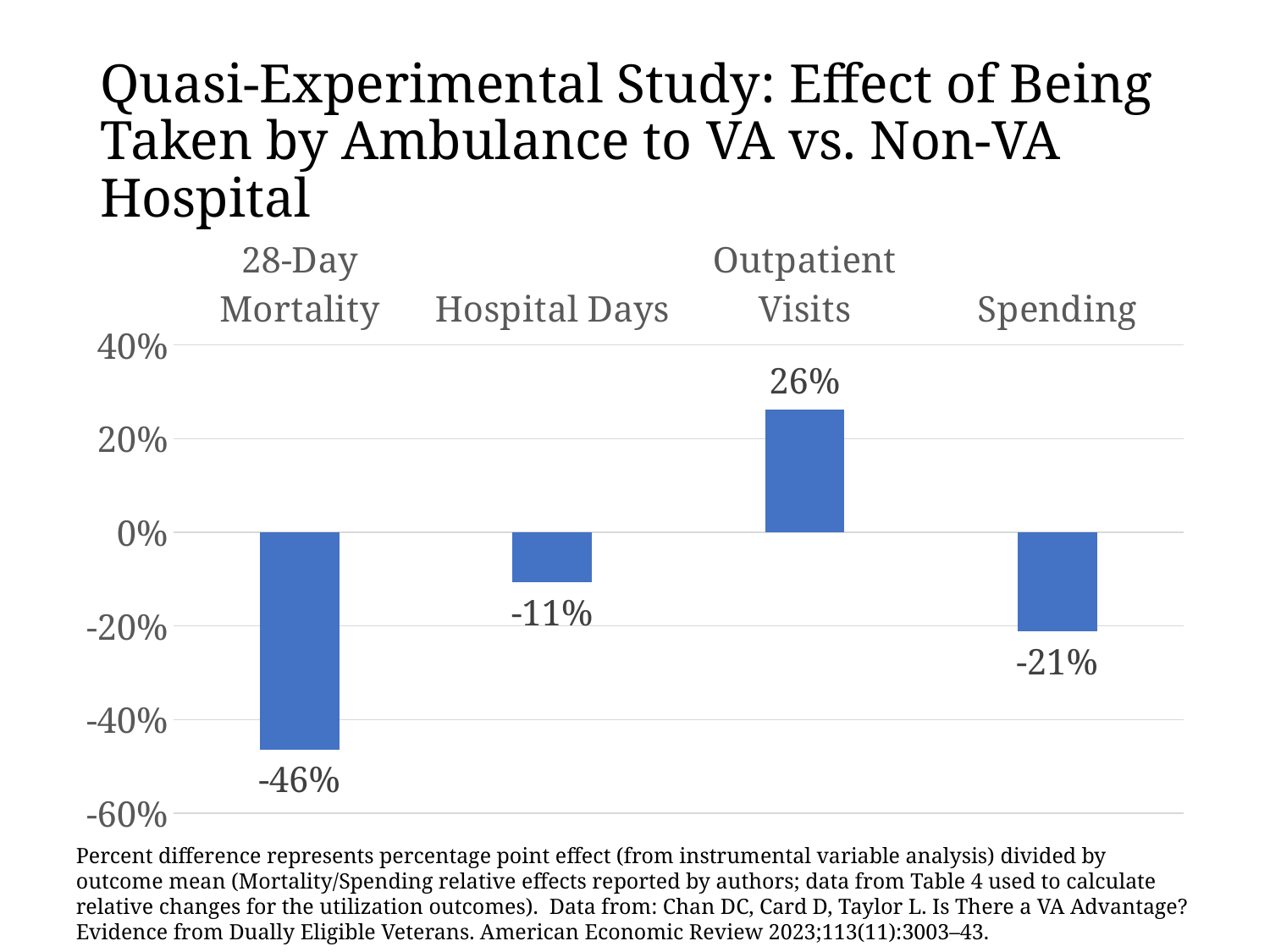
What is the value for Outpatient Visits? 26% Which category has the lowest value? 28-Day Mortality What is the difference between the values for Hospital Days and 28-Day Mortality? 35 percentage points What is the value for 28-Day Mortality? -46% How many categories have a negative value? 3 How many categories are shown in the chart? 4 What is the value for Hospital Days? -11% What kind of chart is shown on the slide? Bar chart What is the value for Spending? -21% What is the difference between the values for Outpatient Visits and Spending? 47 percentage points Which category has the highest value? Outpatient Visits Which is larger, the value for Hospital Days or the value for Spending? Hospital Days